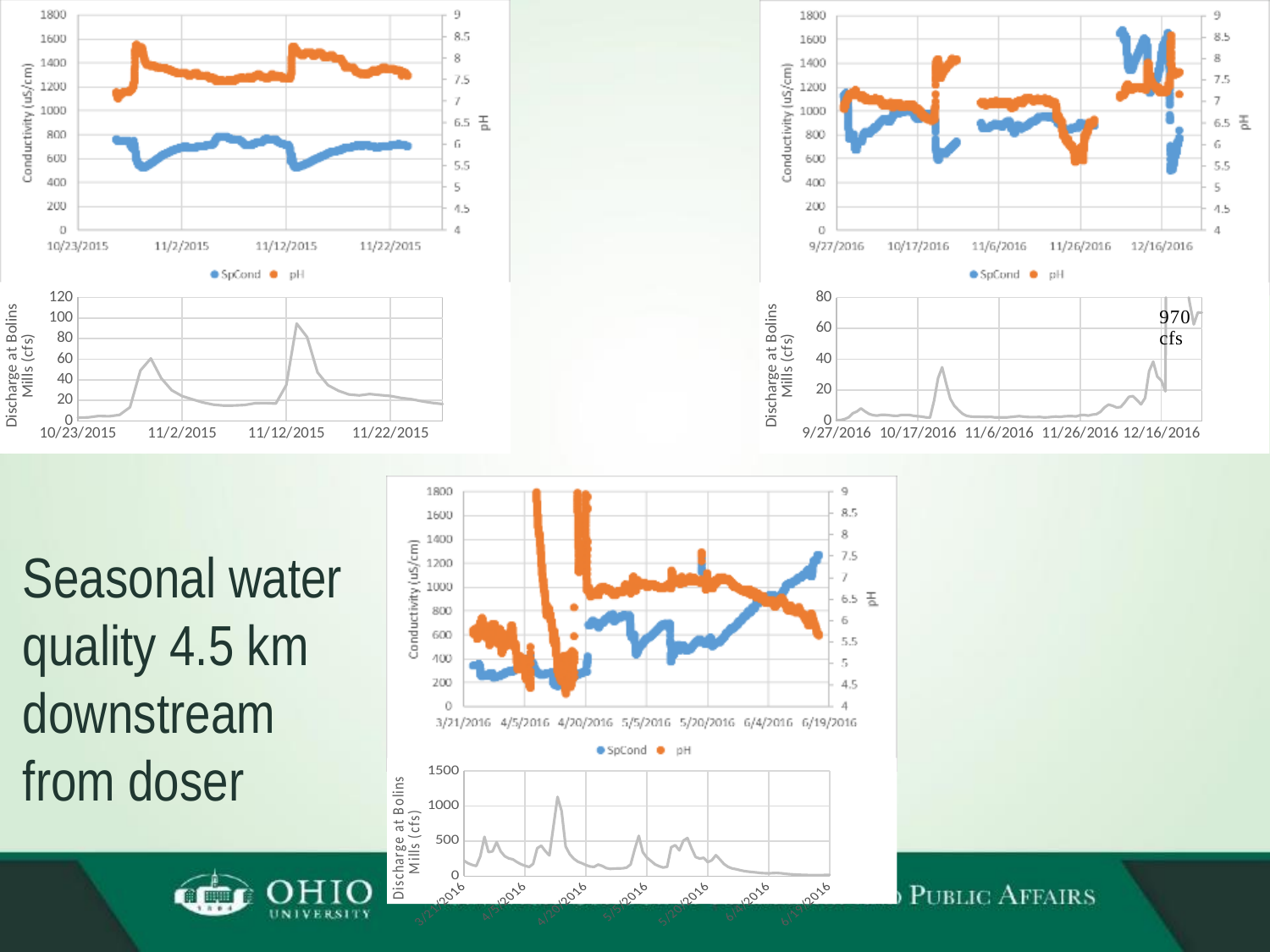
In the top-left conductivity and pH chart, are the SpCond values greater or less than 1000 uS/cm throughout the period? less In the top-left discharge chart (10/23/2015 to 11/22/2015), is the peak discharge value greater or less than 80? greater How many charts are shown on the slide in total? 6 In the bottom-center discharge chart (3/21/2016 to 6/19/2016), is the highest discharge value greater or less than 1000? greater What discharge value is annotated on the top-right discharge chart (9/27/2016 to 12/16/2016)? 970 cfs What kind of chart is the bottom-center discharge chart (3/21/2016 to 6/19/2016)? line chart How many series does the legend list in the top-left conductivity and pH chart? 2 What is the maximum value shown on the y-axis of the top-right discharge chart (9/27/2016 to 12/16/2016)? 80 What is the y-axis label of the discharge chart below the top-left conductivity chart? Discharge at Bolins Mills (cfs) What are the two legend entries in the top-right conductivity and pH chart? SpCond and pH